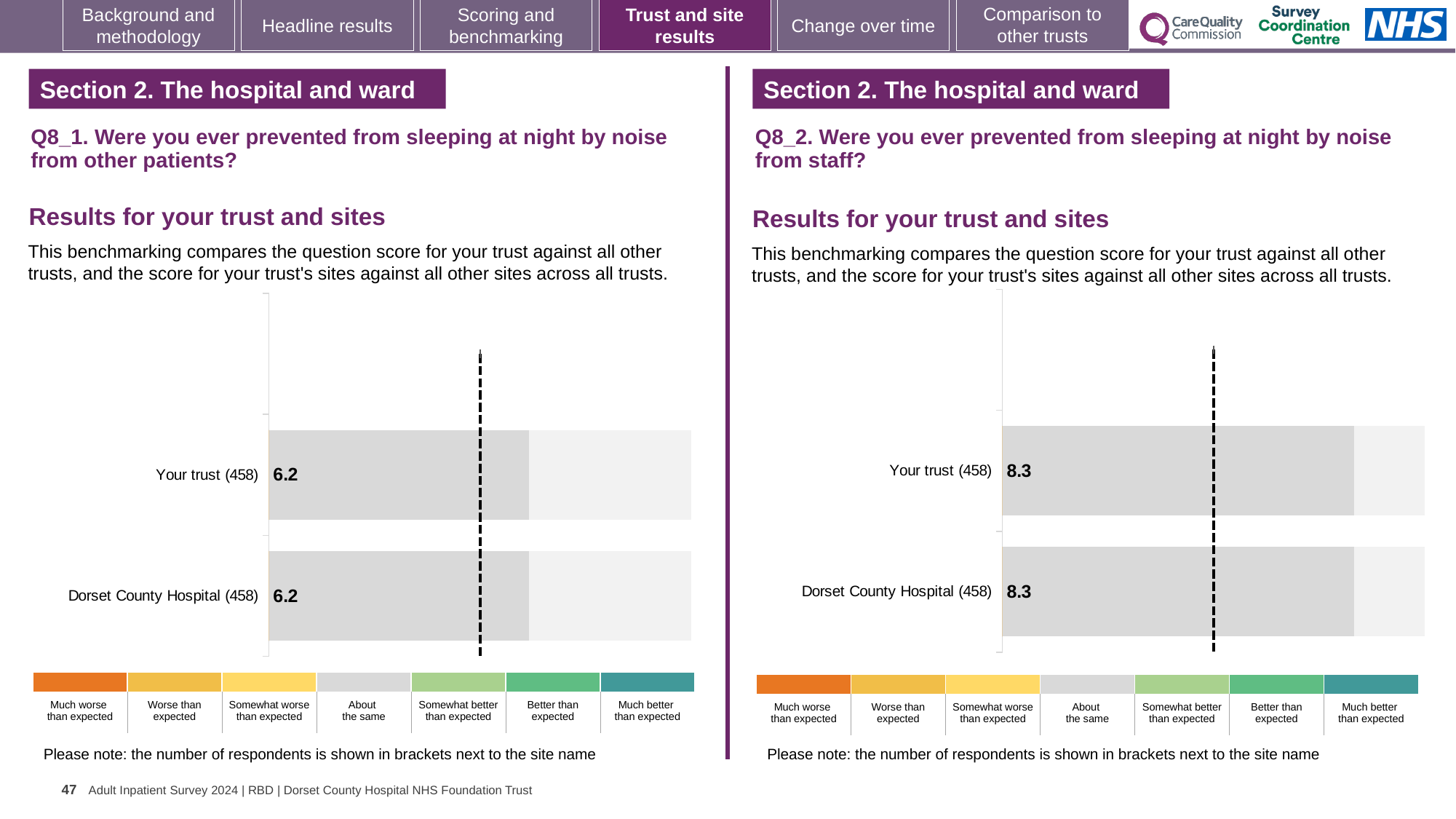
In the Q8_2 chart (right), what is the score for Dorset County Hospital (458)? 8.3 What kind of chart is the Q8_1 chart on the left? Bar chart Is the score for Your trust higher in the Q8_1 chart (left) or the Q8_2 chart (right)? Q8_2 chart (right) In the Q8_2 chart (right), what is the score for Your trust (458)? 8.3 In the Q8_1 chart (left), what is the score for Your trust (458)? 6.2 What is the difference between the Dorset County Hospital score in the Q8_2 chart (right) and in the Q8_1 chart (left)? 2.1 In the Q8_1 chart (left), is the score for Your trust the same as the score for Dorset County Hospital? Yes How many rating categories does the colour key below the Q8_1 chart (left) list? 7 In the Q8_1 chart (left), how many bars are plotted? 2 In the Q8_2 chart (right), how many bars are plotted? 2 In the Q8_1 chart (left), what is the score for Dorset County Hospital (458)? 6.2 How many respondents are shown in brackets next to Your trust in the Q8_2 chart (right)? 458